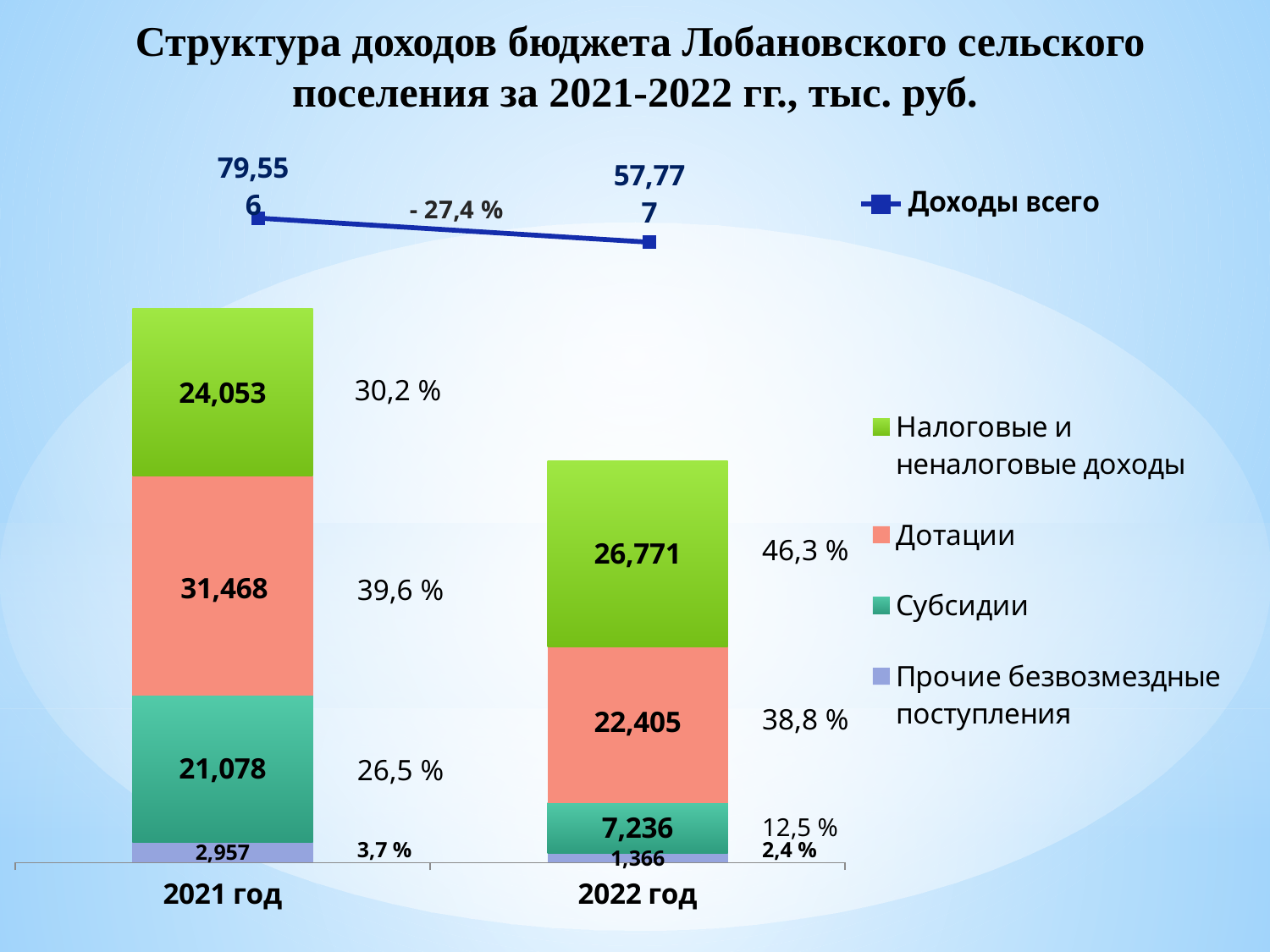
What percentage change is labelled on the Доходы всего line between 2021 год and 2022 год? - 27,4 % What is the value for Дотации in 2021 год? 31,468 What is the value for Субсидии in 2022 год? 7,236 Which series has the largest value in the 2021 год bar? Дотации What is the value for Налоговые и неналоговые доходы in 2022 год? 26,771 Which is larger: Налоговые и неналоговые доходы in 2021 год or in 2022 год? 2022 год Which series has the smallest value in the 2022 год bar? Прочие безвозмездные поступления What is the value for Прочие безвозмездные поступления in 2021 год? 2,957 How many categories are shown on the x axis? 2 How many series does the legend on the lower right list? 4 What is the difference between the Субсидии values for 2021 год and 2022 год? 13,842 What kind of chart is used for the income structure? Stacked bar chart